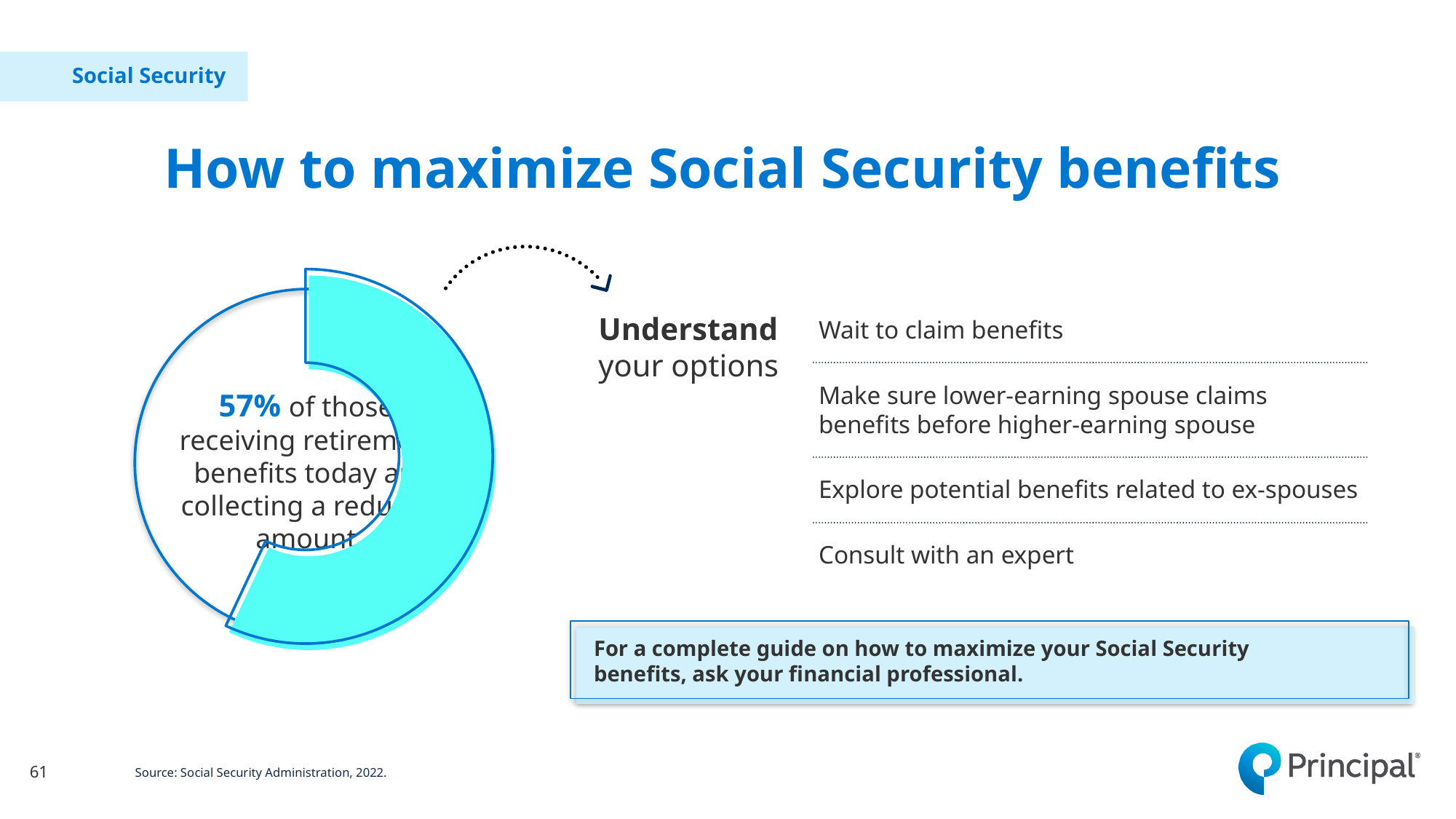
How many segments does the donut chart have? 2 Is the highlighted segment of the donut chart greater or less than 50% of the whole? greater What kind of chart is shown on the left of the slide? pie chart (donut) Which segment of the donut chart is larger, the highlighted (cyan) segment or the unhighlighted (white) segment? the highlighted (cyan) segment What source is cited for the donut chart data? Social Security Administration, 2022 What colour is the highlighted segment of the donut chart? cyan (light blue) According to the donut chart, what share of those receiving retirement benefits today are collecting a reduced amount? 57% What percentage does the highlighted segment of the donut chart represent? 57%